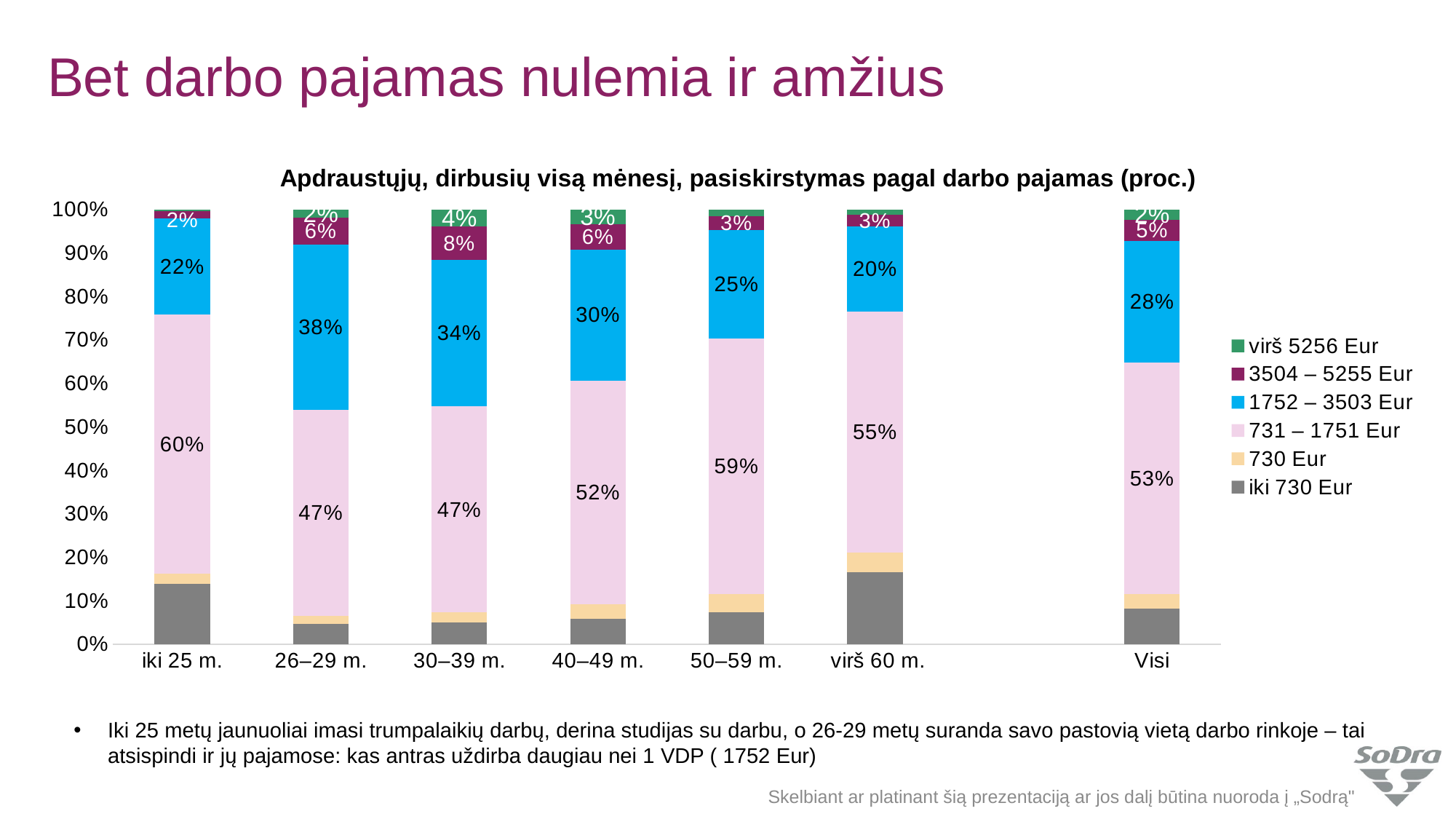
What is the value for the 3504 – 5255 Eur series in the 30–39 m. category? 8% What kind of chart is shown on the slide? Stacked bar chart Which category has the lowest value for the 1752 – 3503 Eur series? virš 60 m. What is the value for the 731 – 1751 Eur series in the iki 25 m. category? 60% Is the value for the iki 730 Eur series in the virš 60 m. category greater or less than 10%? greater What is the value for the 1752 – 3503 Eur series in the 26–29 m. category? 38% How many series does the legend list? 6 Which category has the highest value for the 1752 – 3503 Eur series? 26–29 m. What is the difference between the 731 – 1751 Eur values for iki 25 m. and 26–29 m.? 13 percentage points How many categories are shown on the x axis? 7 What is the value for the 1752 – 3503 Eur series in the Visi category? 28% Which has the larger 731 – 1751 Eur value, 50–59 m. or virš 60 m.? 50–59 m.